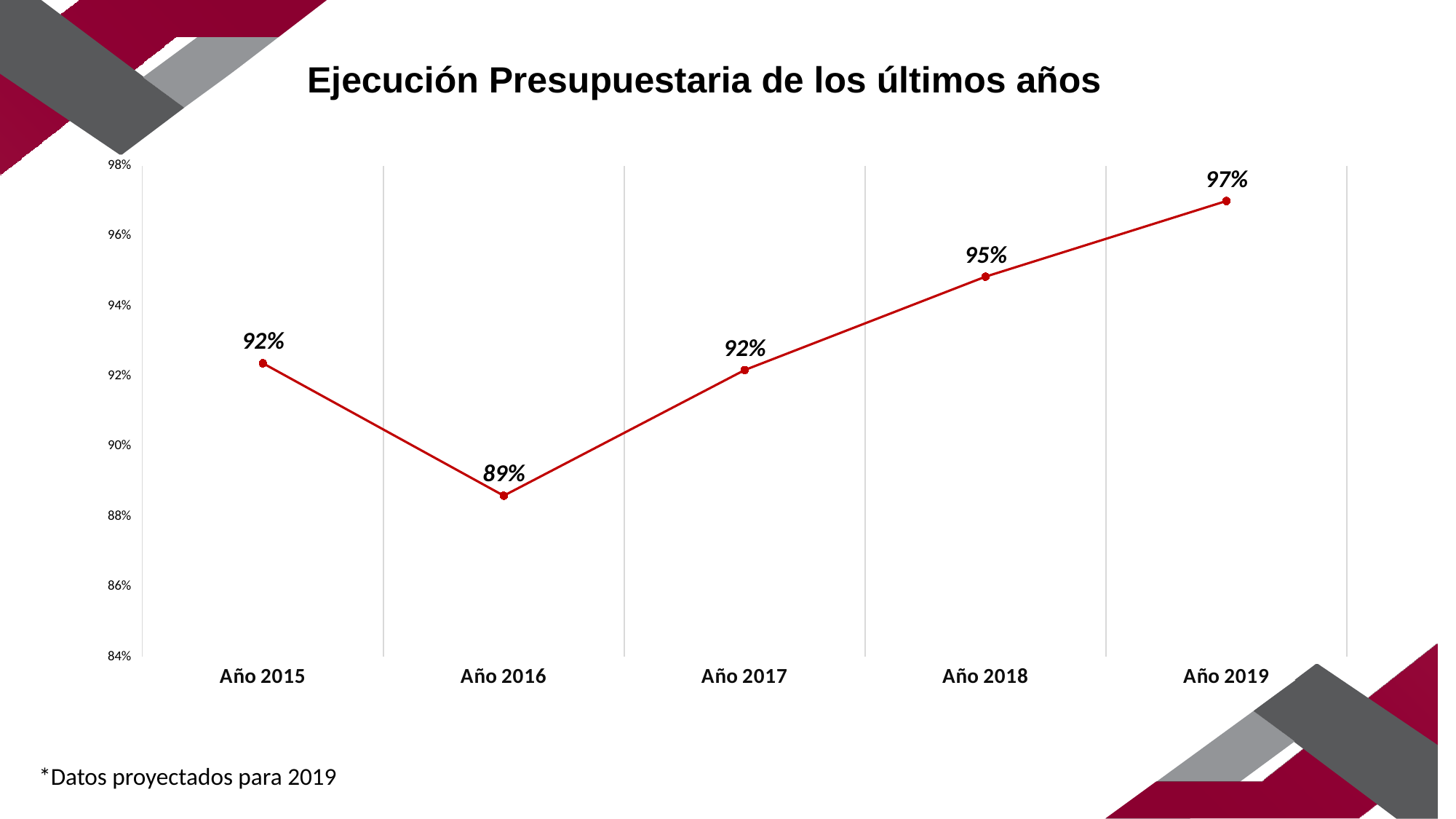
What is the value for Año 2016? 89% What kind of chart is shown on the slide? line chart What is the difference between the values for Año 2019 and Año 2016? 8% What is the difference between the values for Año 2018 and Año 2017? 3% Is the value for Año 2016 greater or less than 90%? less Which year has the highest value? Año 2019 What is the value for Año 2018? 95% Which is larger, the value for Año 2018 or the value for Año 2015? Año 2018 How many years are plotted on the chart? 5 What is the title of the chart? Ejecución Presupuestaria de los últimos años What is the value for Año 2019? 97% Which year has the lowest value? Año 2016